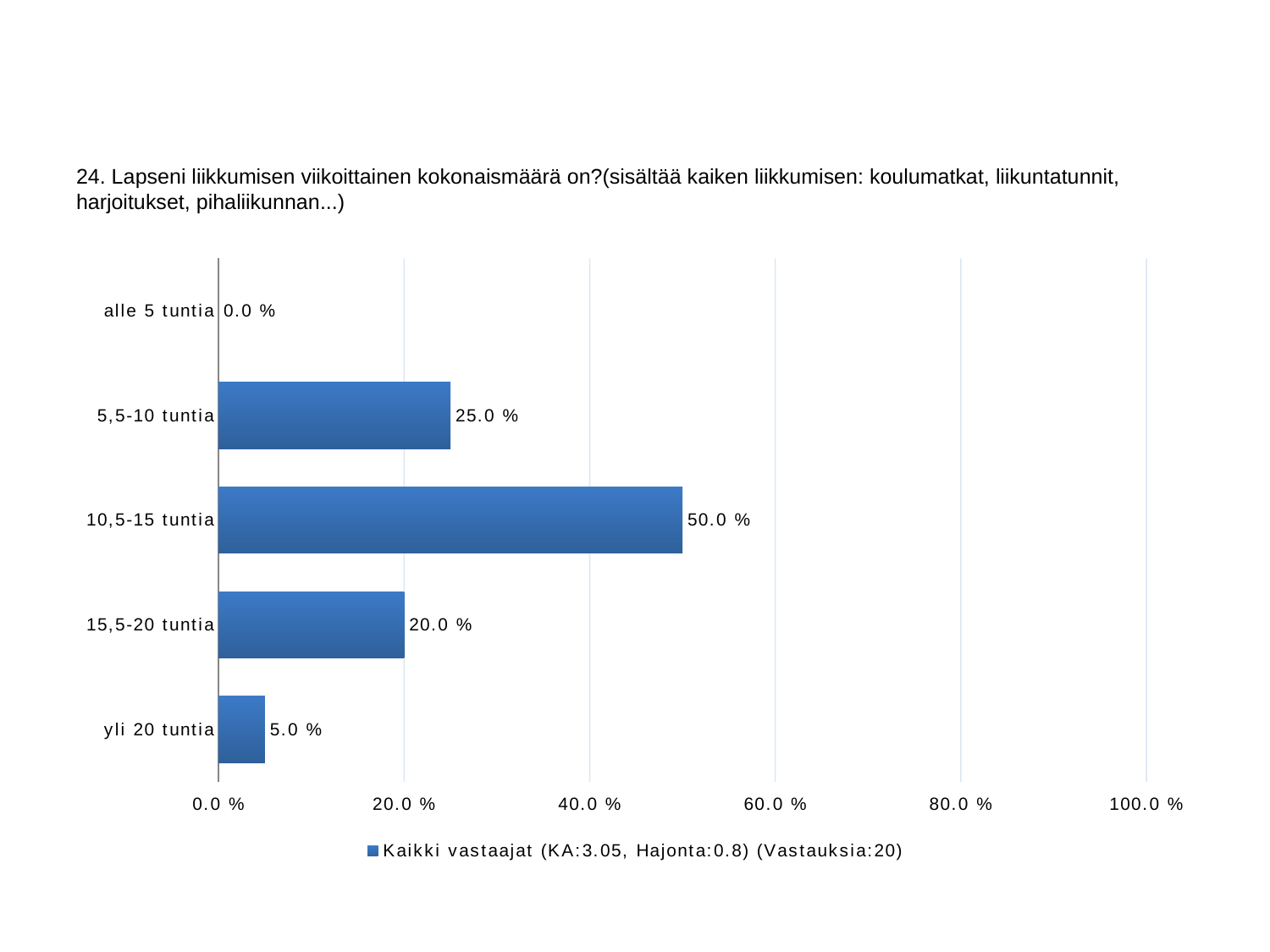
Which is larger, the value for "5,5-10 tuntia" or the value for "15,5-20 tuntia"? 5,5-10 tuntia Which category has the highest value? 10,5-15 tuntia How many categories are shown on the chart? 5 What kind of chart is shown on the slide? bar chart What is the difference between the values for "10,5-15 tuntia" and "15,5-20 tuntia"? 30.0 % What is the value for "10,5-15 tuntia"? 50.0 % What is the value for "alle 5 tuntia"? 0.0 % What is the value for "5,5-10 tuntia"? 25.0 % How many series does the legend list? 1 Is the value for "10,5-15 tuntia" greater or less than 40.0 %? greater Which category has the lowest value? alle 5 tuntia What is the value for "yli 20 tuntia"? 5.0 %